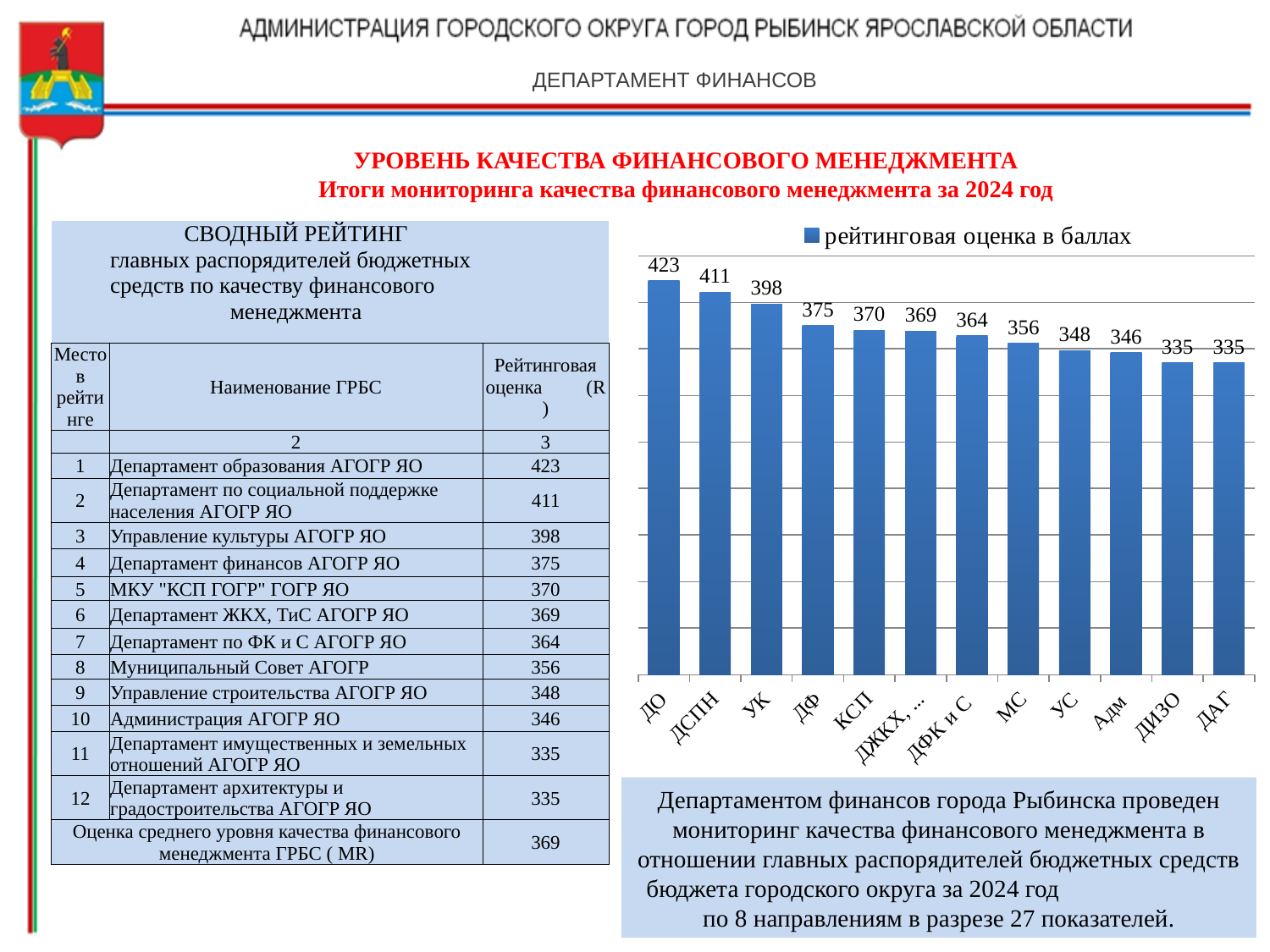
What type of chart is shown on the slide? bar chart What is the difference between the values for ДФ and УС? 27 What is the value for УК in the chart? 398 Do the values rise or fall from left to right along the x axis? fall What is the difference between the values for ДО and ДСПН? 12 Which category has the highest value in the chart? ДО What is the value for Адм in the chart? 346 What is the value for ДО in the chart? 423 How many series does the chart legend list? 1 Which is larger, the value for КСП or the value for ДФК и С? КСП How many categories are shown on the x axis of the chart? 12 What is the value for МС in the chart? 356